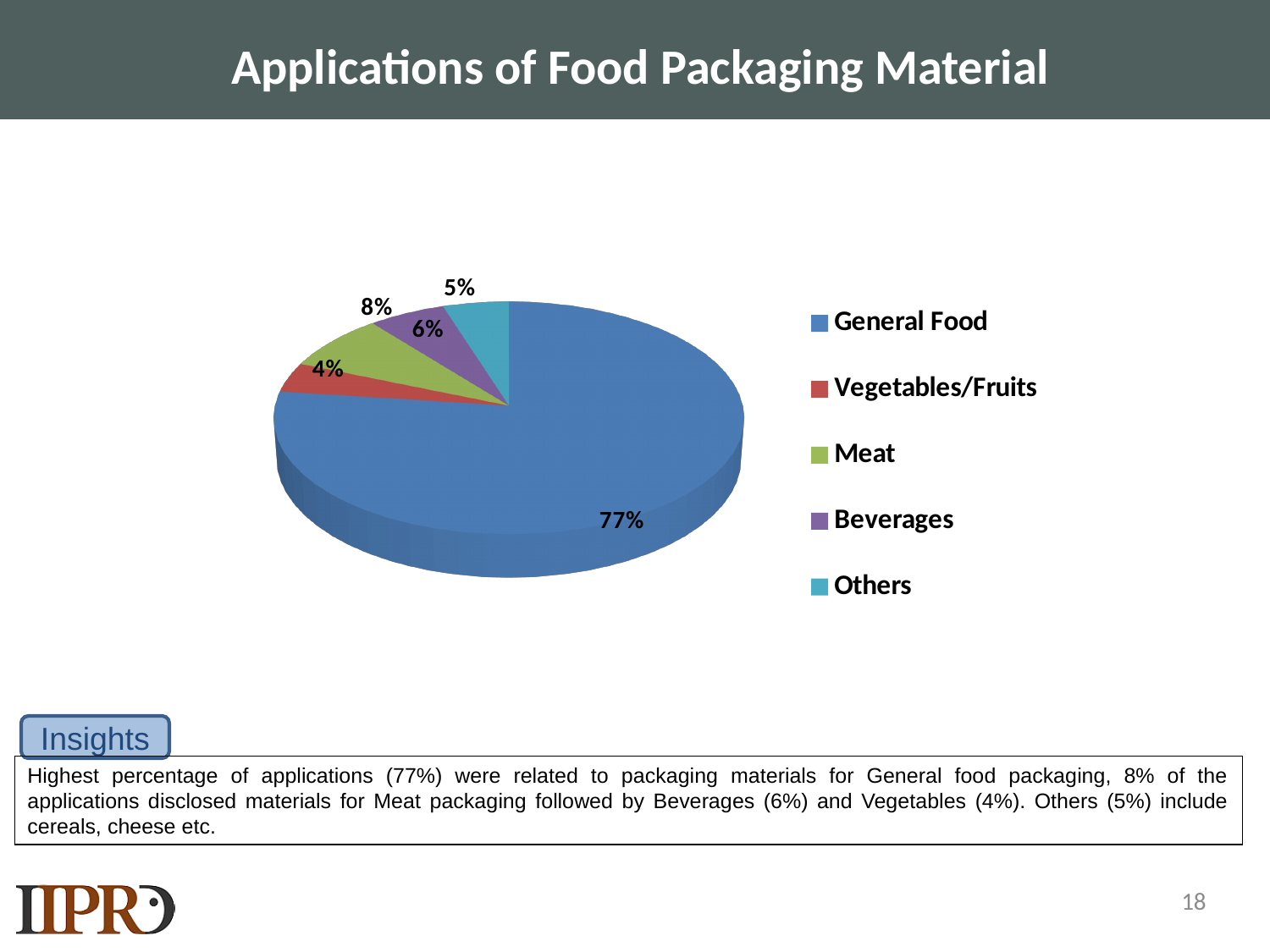
What percentage is shown for Beverages? 6% Which category has the smallest share of the pie? Vegetables/Fruits What percentage is shown for Vegetables/Fruits? 4% What percentage is shown for Others? 5% What is the title of the slide containing the chart? Applications of Food Packaging Material What kind of chart is shown on the slide? Pie chart What percentage is shown for Meat? 8% Which category has the largest share of the pie? General Food What share of the pie does General Food account for? 77% How many categories does the legend list? 5 Which has a larger share, Beverages or Others? Beverages What is the difference in percentage points between Meat and Beverages? 2